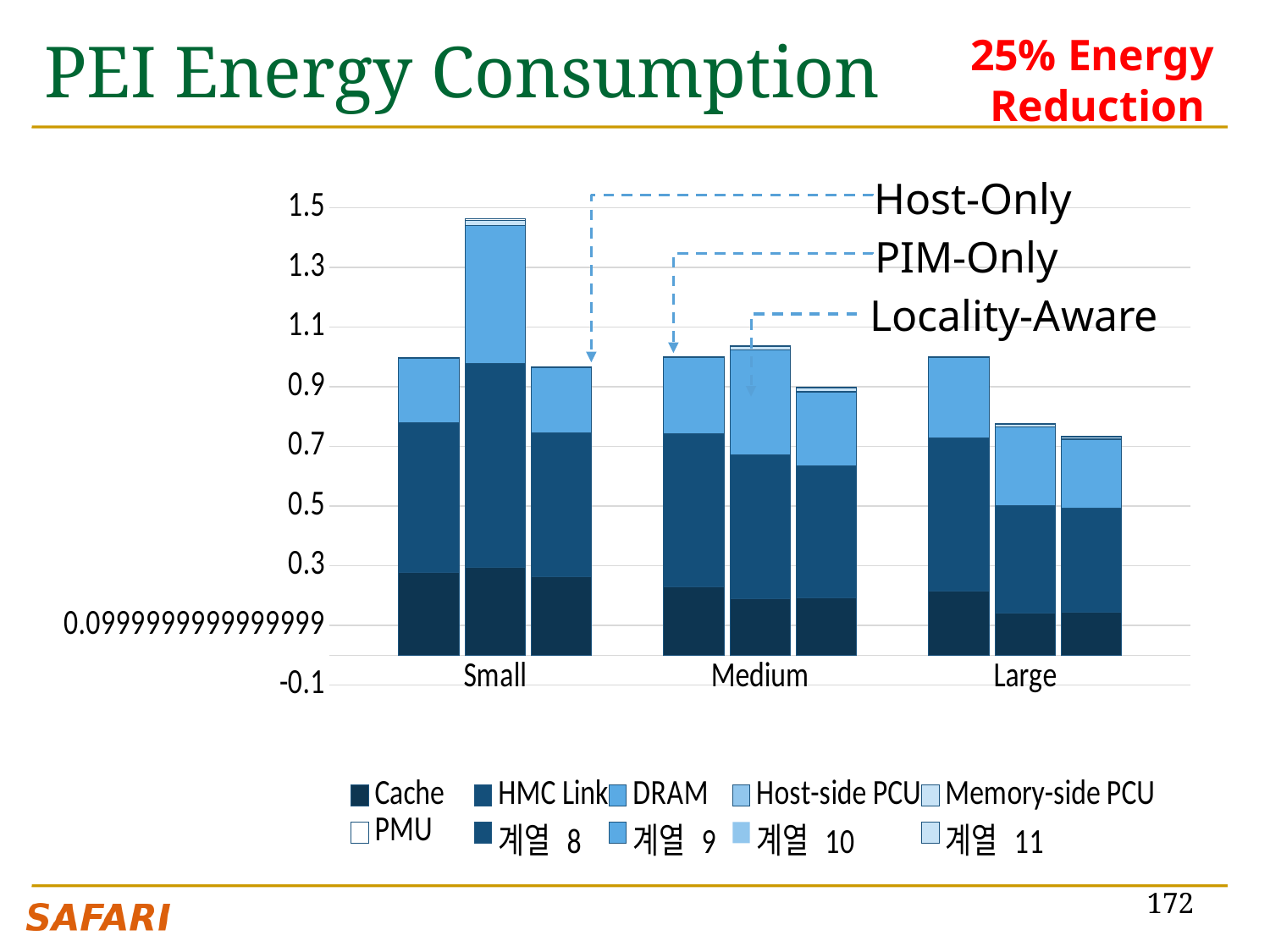
What kind of chart is shown on the slide? stacked bar chart Which is larger for Medium: the PIM-Only bar or the Locality-Aware bar? PIM-Only How many categories are shown on the x axis of the chart? 3 What is the title of the chart on the slide? PEI Energy Consumption Which bar is the tallest in the chart? PIM-Only for Small Within the Medium group, which bar is the lowest? Locality-Aware How many series does the chart's legend list? 10 Is the total of the PIM-Only bar for Medium greater or less than 0.9? greater Which is larger for Large: the Host-Only bar or the Locality-Aware bar? Host-Only Is the total of the Host-Only bar for Large greater or less than 1.1? less Is the total of the PIM-Only bar for Small greater or less than 1.3? greater Do the Locality-Aware bars rise or fall from Small to Large? fall